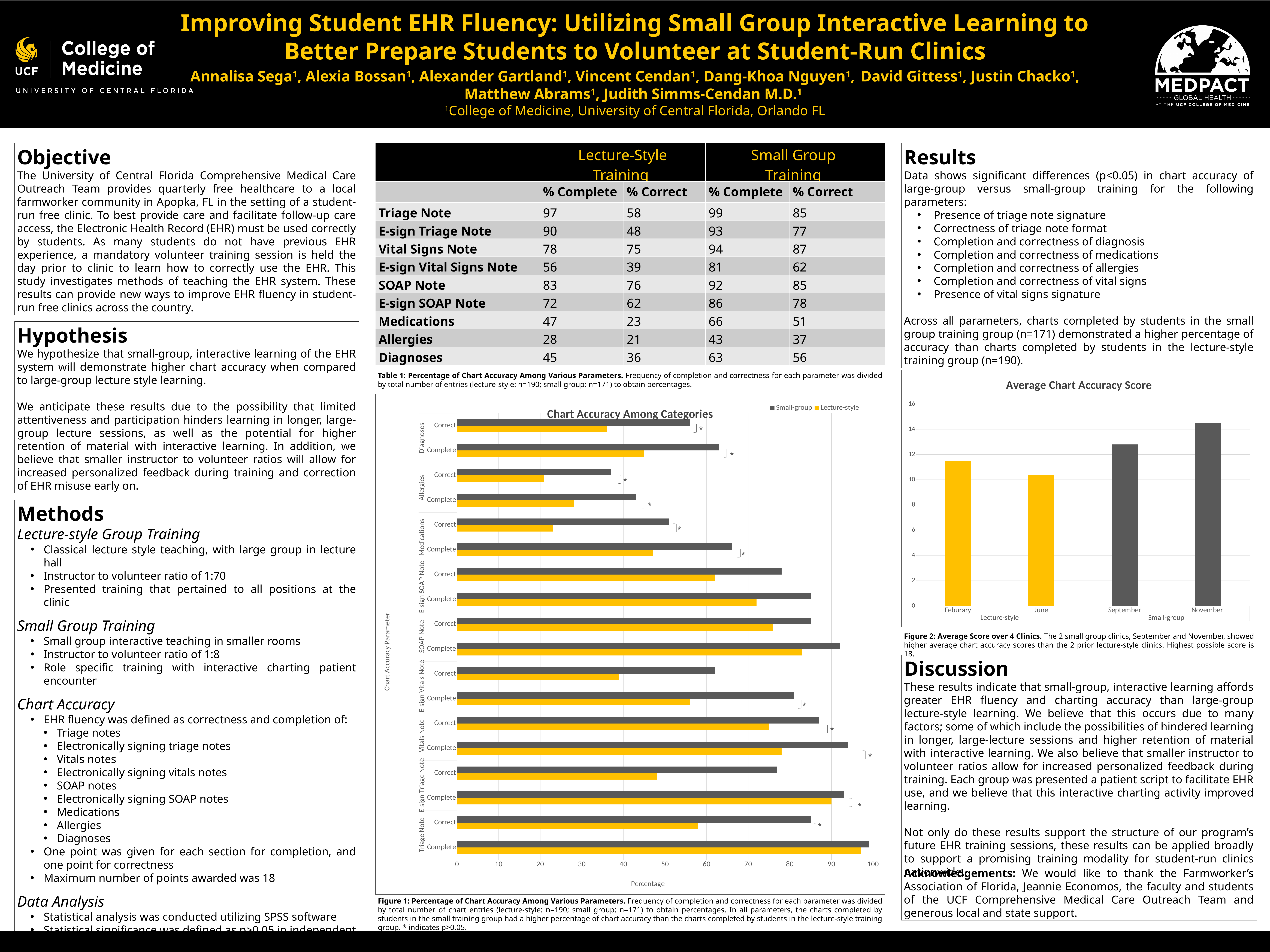
In the 'Chart Accuracy Among Categories' chart, what are the two series named in the legend? Small-group and Lecture-style What kind of chart is the 'Chart Accuracy Among Categories' chart? bar chart In the 'Chart Accuracy Among Categories' chart, what is the label of the x axis? Percentage In the 'Average Chart Accuracy Score' chart, is the value for September greater or less than 12? greater In the 'Chart Accuracy Among Categories' chart, which series has the larger value for Vitals Note Correct, Small-group or Lecture-style? Small-group In the 'Average Chart Accuracy Score' chart, which month has the lowest average score? June In the 'Chart Accuracy Among Categories' chart, is the Small-group value for Triage Note Complete greater or less than 90? greater In the 'Chart Accuracy Among Categories' chart, is the Lecture-style value for Medications Correct greater or less than 30? less What kind of chart is the 'Average Chart Accuracy Score' chart? bar chart In the 'Chart Accuracy Among Categories' chart, how many series does the legend list? 2 In the 'Average Chart Accuracy Score' chart, which month has the highest average score? November In the 'Average Chart Accuracy Score' chart, how many bars are plotted? 4